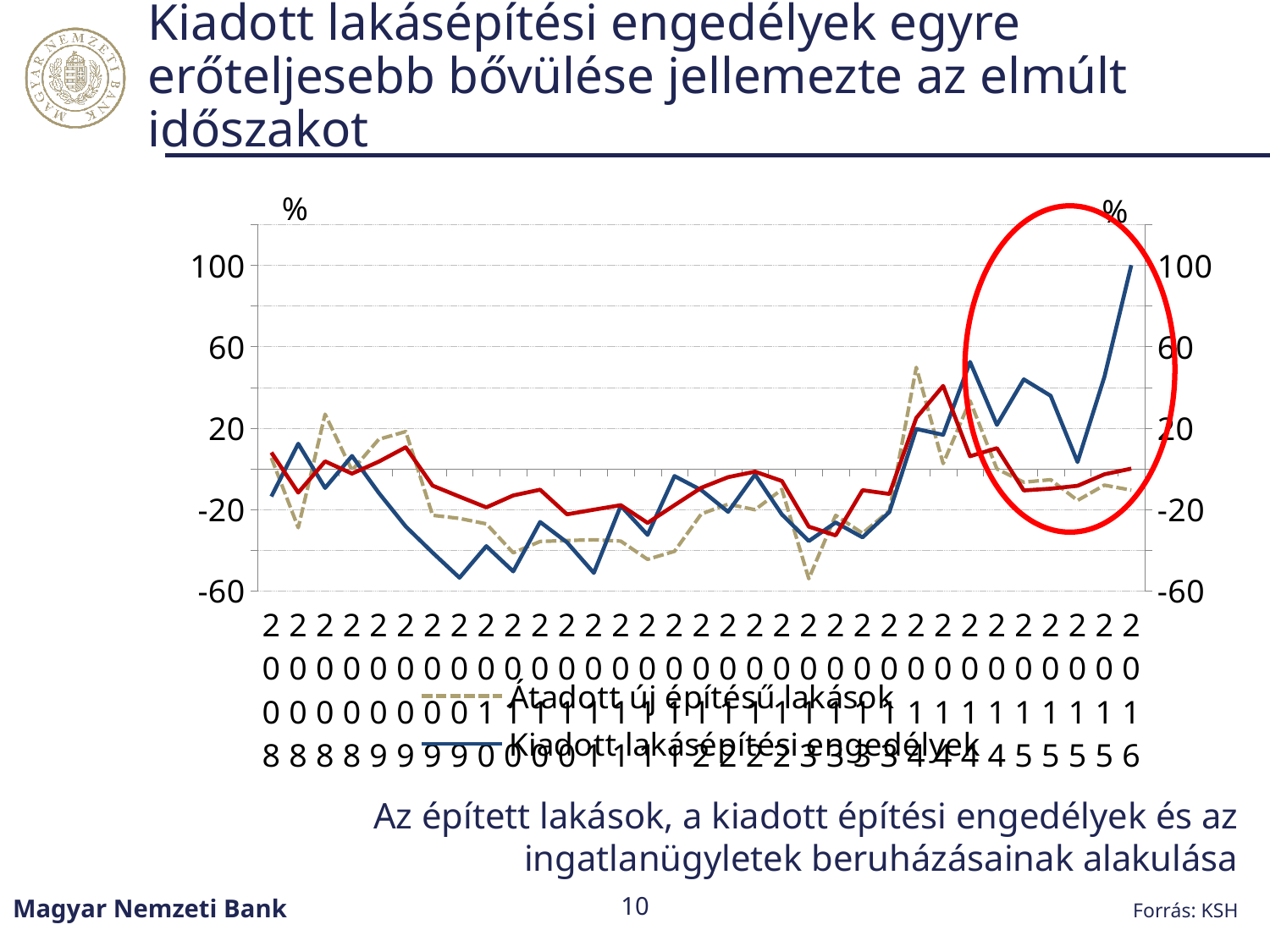
Which series reaches the highest value at the right end of the chart (2016)? Kiadott lakásépítési engedélyek Which series is drawn with a dashed line in the chart? Átadott új építésű lakások What unit is shown on the vertical axes of the chart? % Is the peak of the Átadott új építésű lakások series around 2014 greater or less than 20? greater In which year does the x axis of the chart begin? 2008 What is the lowest value labelled on the vertical axis of the chart? -60 Is the lowest value of the Kiadott lakásépítési engedélyek series (around 2009–2010) greater or less than -20? less What kind of chart is shown on the slide? line chart Does the Kiadott lakásépítési engedélyek series rise or fall over the last few points leading up to 2016? rise Is the final 2016 value of the Kiadott lakásépítési engedélyek series greater or less than 60? greater In which year does the x axis of the chart end? 2016 What is the highest value labelled on the vertical axis of the chart? 100